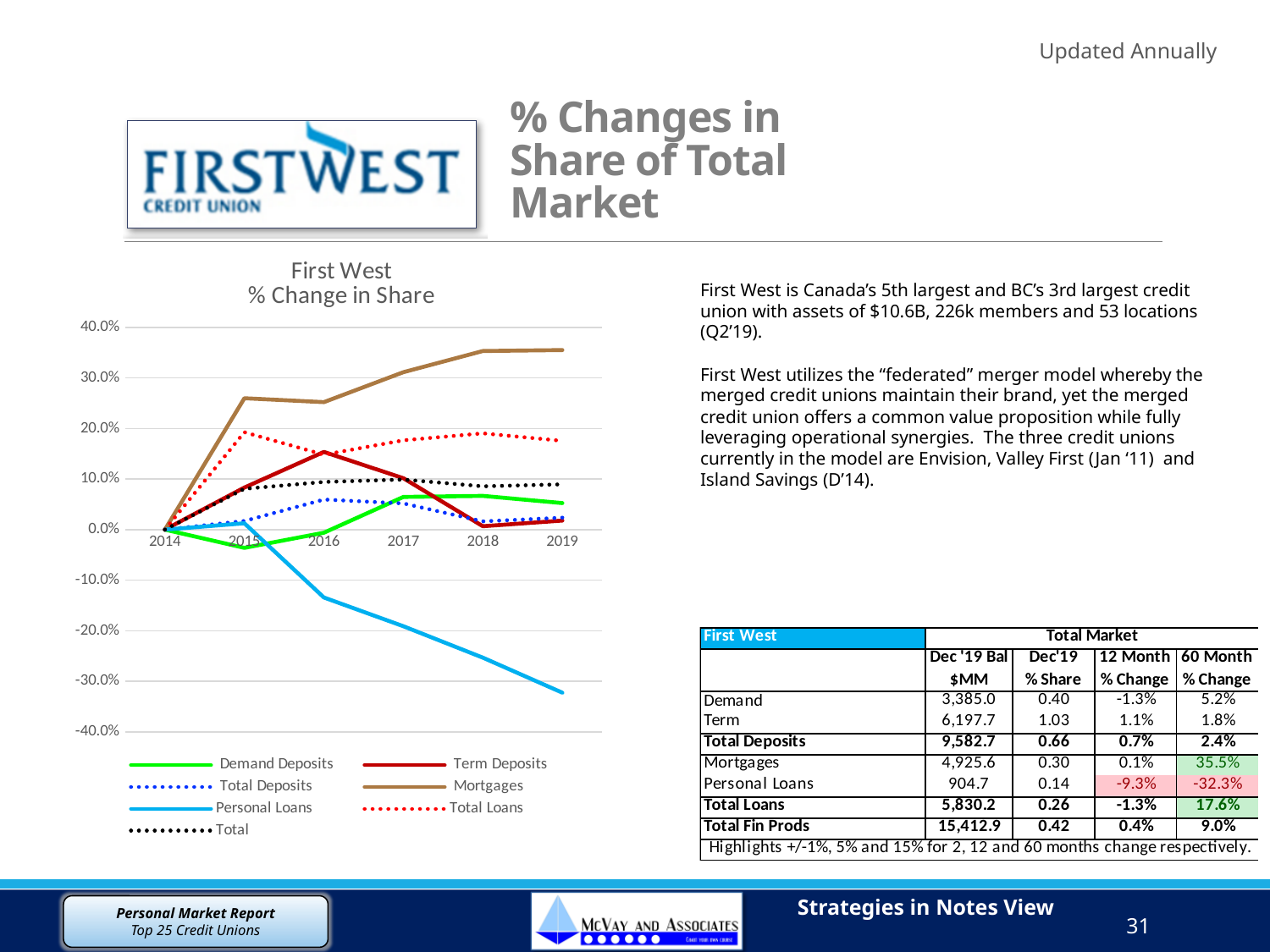
What kind of chart is shown on the slide? line chart In 2016, which is larger: Term Deposits or Demand Deposits? Term Deposits Is the value for Mortgages in 2019 greater or less than 30.0%? greater Which series has the highest value in 2019? Mortgages Does the Personal Loans line rise or fall from 2015 to 2019? fall How many series does the chart legend list? 7 Is the value for Personal Loans in 2019 greater or less than -20.0%? less What is the title of the chart? First West % Change in Share Does the Mortgages line rise or fall from 2014 to 2018? rise How many years are shown along the x axis of the chart? 6 Which series has the lowest value in 2019? Personal Loans Is the value for Total Loans in 2019 greater or less than 10.0%? greater